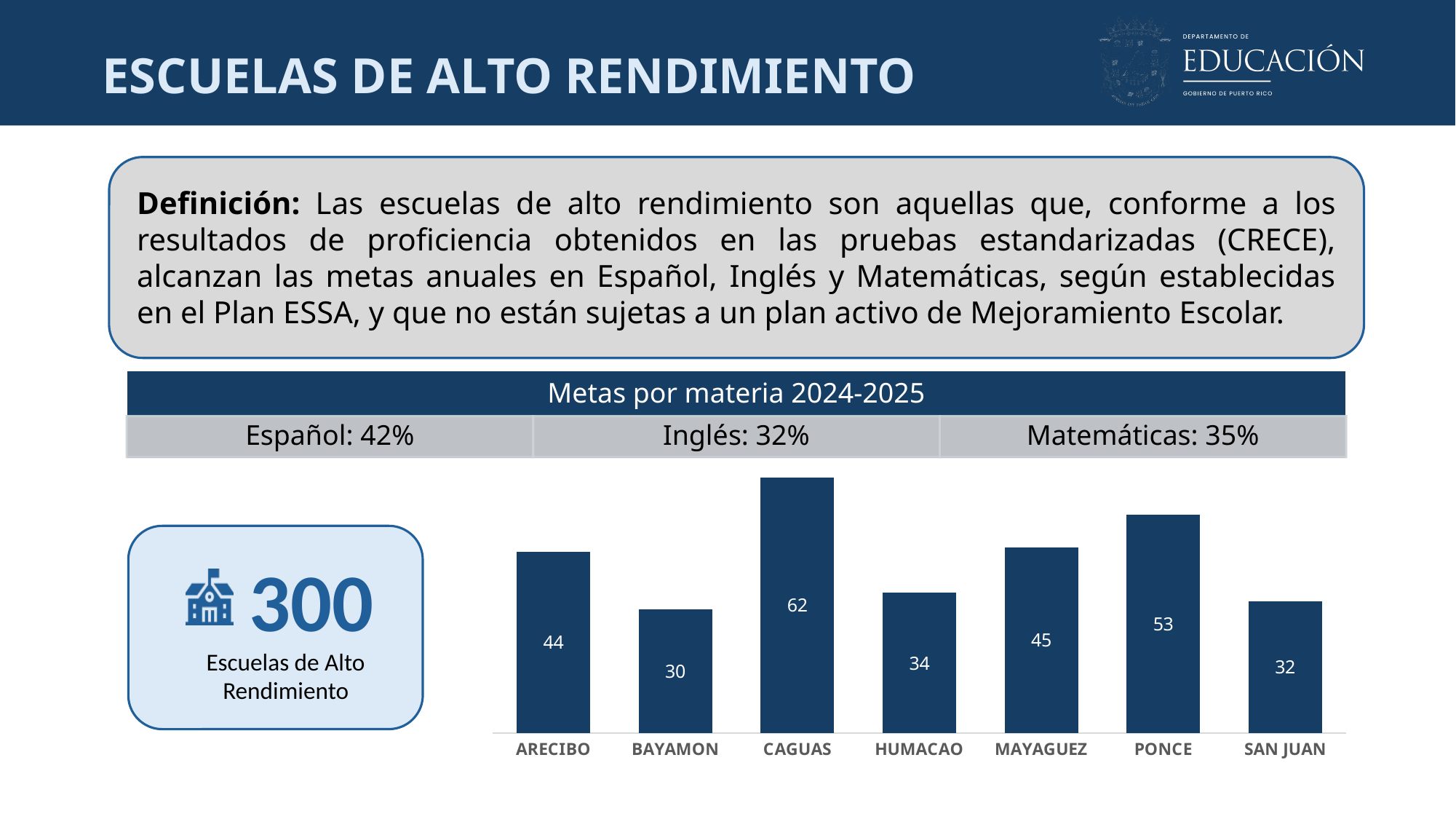
What is the value for SAN JUAN in the bar chart? 32 What is the value for PONCE in the bar chart? 53 What is the difference between the values for CAGUAS and BAYAMON? 32 What is the value for CAGUAS in the bar chart? 62 How many regions are shown in the bar chart? 7 Which region has the highest value in the bar chart? CAGUAS Which has a larger value, ARECIBO or HUMACAO? ARECIBO What is the total of all the values shown in the bar chart? 300 What kind of chart is shown on the slide? Bar chart What is the difference between the values for PONCE and MAYAGUEZ? 8 Which region has the lowest value in the bar chart? BAYAMON What is the value for BAYAMON in the bar chart? 30